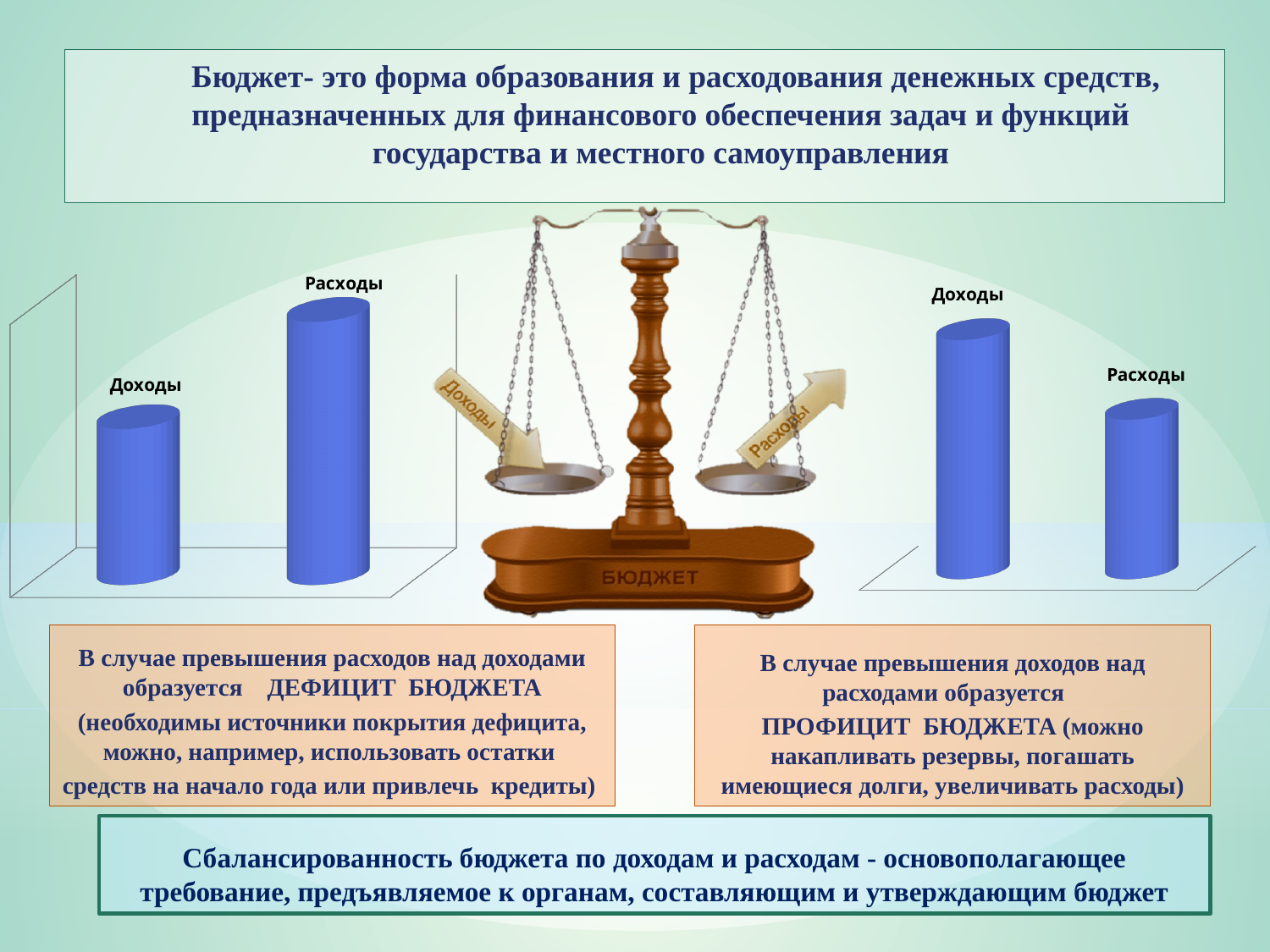
What colour are the bars in both charts? blue What are the two category labels shown in the left chart? Доходы and Расходы In the left chart, which category has the shorter bar? Доходы What kind of chart is shown on the left side of the slide? bar chart In the left chart, is the bar for Доходы taller or shorter than the bar for Расходы? shorter In the left chart, which category has the taller bar? Расходы What kind of chart is shown on the right side of the slide? bar chart In the left chart, how many bars are plotted? 2 In the right chart, is the bar for Расходы taller or shorter than the bar for Доходы? shorter In the right chart, how many bars are plotted? 2 In the right chart, which category has the taller bar? Доходы In the right chart, which category has the shorter bar? Расходы